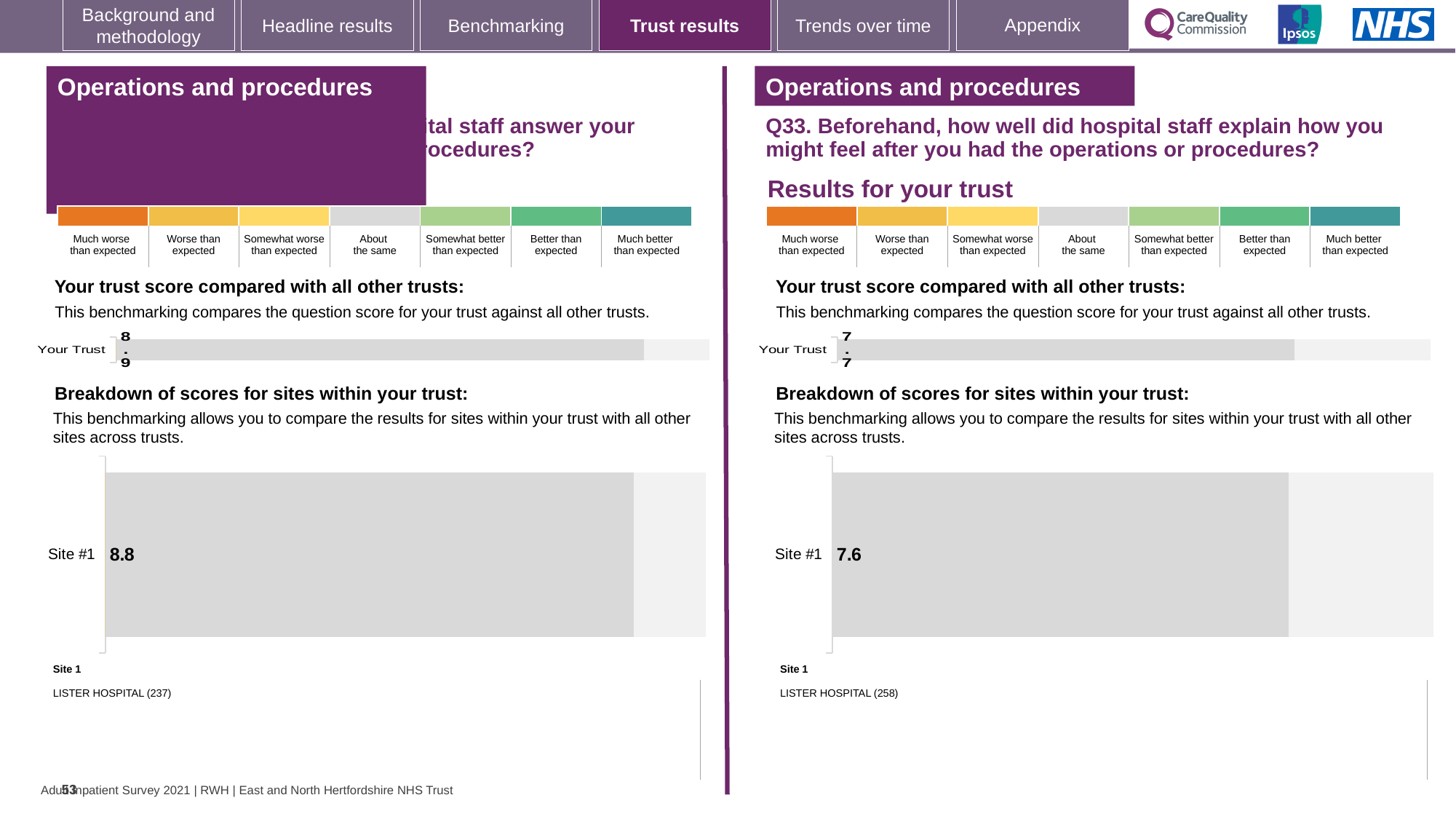
On the left half of the slide, which is larger: the Your Trust score or the Site #1 score? Your Trust (8.9) Which hospital is listed as Site 1 on the left half of the slide? LISTER HOSPITAL (237) What is the difference between the Your Trust score on the left half of the slide (8.9) and the Your Trust score on the right half (7.7)? 1.2 Which is larger: the Site #1 score on the left half of the slide or the Site #1 score on the right half (Q33)? Left half (8.8) Which hospital is listed as Site 1 on the right half of the slide (Q33)? LISTER HOSPITAL (258) On the left half of the slide, what is the score shown for Your Trust in the 'Your trust score compared with all other trusts' chart? 8.9 On the right half of the slide (Q33), what is the score shown for Your Trust in the 'Your trust score compared with all other trusts' chart? 7.7 How many sites are shown in the breakdown of scores for sites chart on the right half of the slide (Q33)? 1 On the right half of the slide (Q33), what is the difference between the Your Trust score and the Site #1 score? 0.1 What kind of chart is used to show the Site #1 score on the right half of the slide (Q33)? Bar chart On the left half of the slide, what score is shown for Site #1 in the breakdown of scores for sites chart? 8.8 On the right half of the slide (Q33), what score is shown for Site #1 in the breakdown of scores for sites chart? 7.6